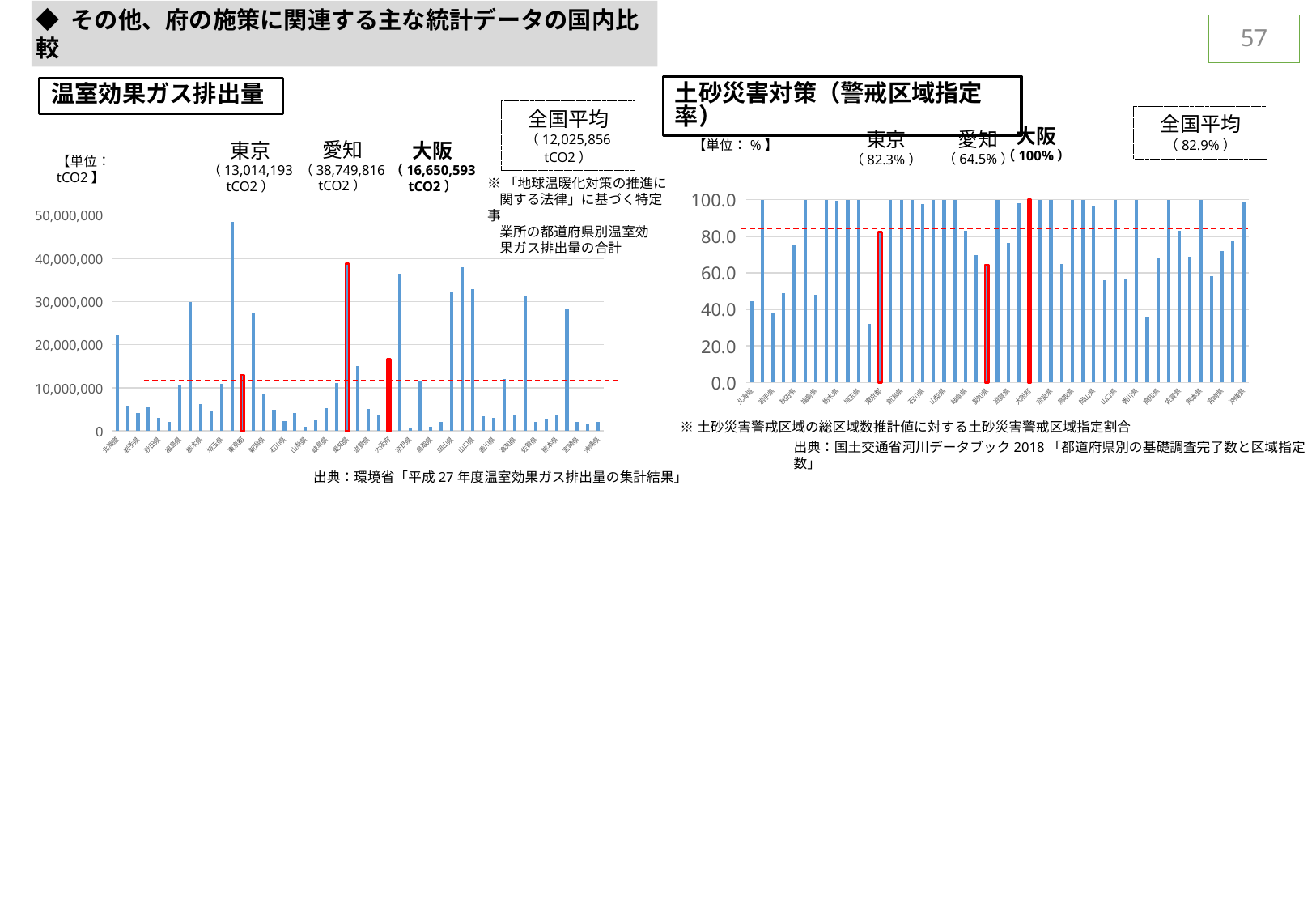
In the 土砂災害対策（警戒区域指定率） chart, what is the difference between the values for 大阪 and 愛知? 35.5% In the 土砂災害対策（警戒区域指定率） chart, what is the 全国平均 (national average) shown? 82.9% In the 土砂災害対策（警戒区域指定率） chart, what is the value for 大阪? 100% In the 温室効果ガス排出量 chart, what is the value for 愛知? 38,749,816 tCO2 In the 土砂災害対策（警戒区域指定率） chart, which is larger, the value for 東京 or the value for 愛知? 東京 In the 土砂災害対策（警戒区域指定率） chart, what is the value for 愛知? 64.5% In the 温室効果ガス排出量 chart, is the value for 東京 greater or less than 10,000,000? greater In the 温室効果ガス排出量 chart, which is larger, the value for 愛知 or the value for 東京? 愛知 In the 温室効果ガス排出量 chart, what is the difference between the values for 大阪 and 東京? 3,636,400 tCO2 What kind of chart is the 温室効果ガス排出量 chart on the left? bar chart In the 温室効果ガス排出量 chart, what is the value for 大阪? 16,650,593 tCO2 In the 温室効果ガス排出量 chart, what is the 全国平均 (national average) shown? 12,025,856 tCO2